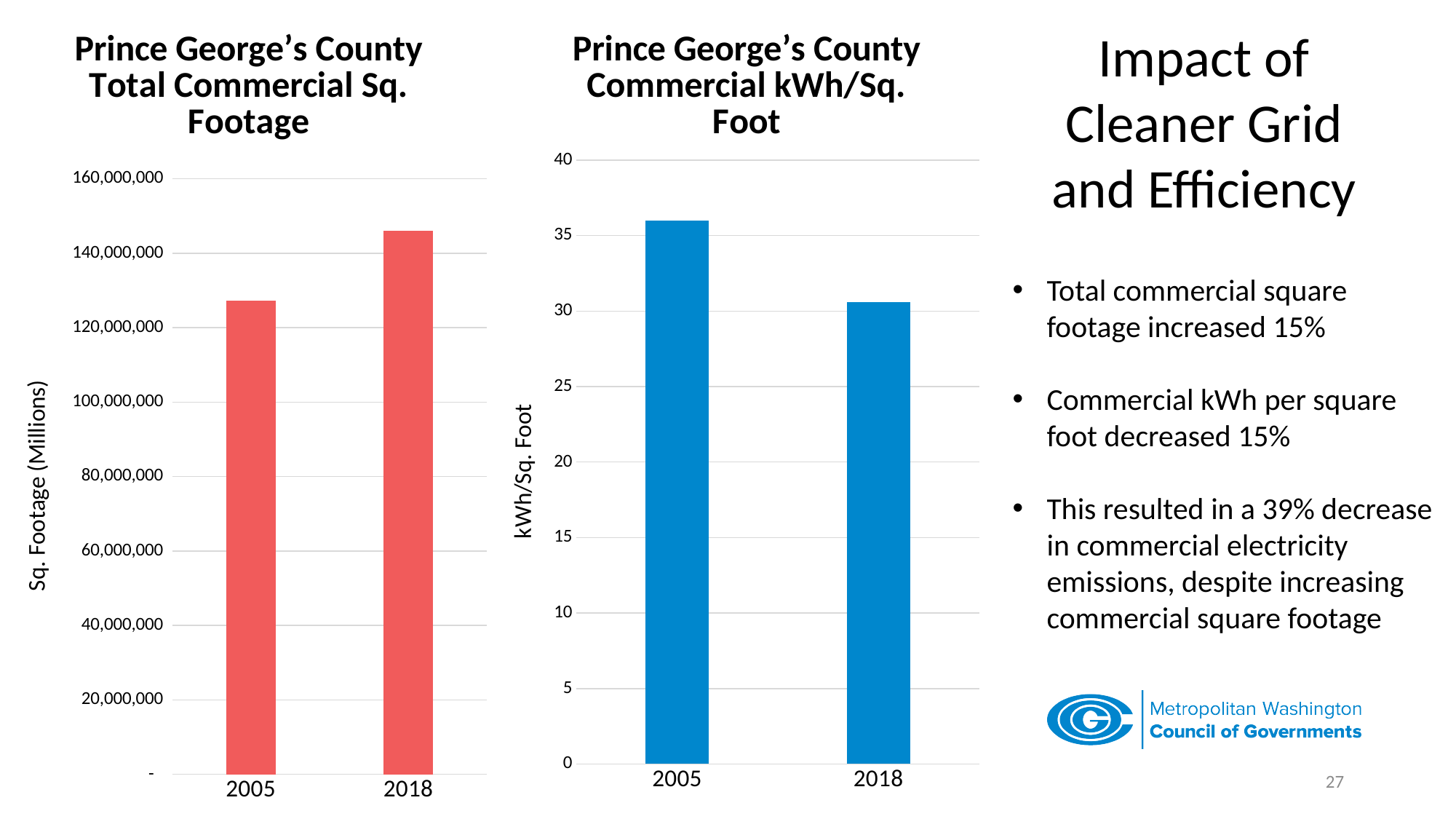
What kind of chart is the 'Prince George's County Total Commercial Sq. Footage' chart? bar chart In the 'Prince George's County Commercial kWh/Sq. Foot' chart, which year has the higher value, 2005 or 2018? 2005 What is the y-axis title of the 'Prince George's County Total Commercial Sq. Footage' chart? Sq. Footage (Millions) What colour are the bars in the 'Prince George's County Commercial kWh/Sq. Foot' chart? blue In the 'Prince George's County Total Commercial Sq. Footage' chart, do the values rise or fall from 2005 to 2018? rise In the 'Prince George's County Commercial kWh/Sq. Foot' chart, do the values rise or fall from 2005 to 2018? fall In the 'Prince George's County Commercial kWh/Sq. Foot' chart, is the value for 2018 greater or less than 35? less In the 'Prince George's County Total Commercial Sq. Footage' chart, is the value for 2018 greater or less than 140,000,000? greater In the 'Prince George's County Total Commercial Sq. Footage' chart, which year has the higher value, 2005 or 2018? 2018 In the 'Prince George's County Total Commercial Sq. Footage' chart, is the value for 2005 greater or less than 140,000,000? less In the 'Prince George's County Total Commercial Sq. Footage' chart, how many years are plotted? 2